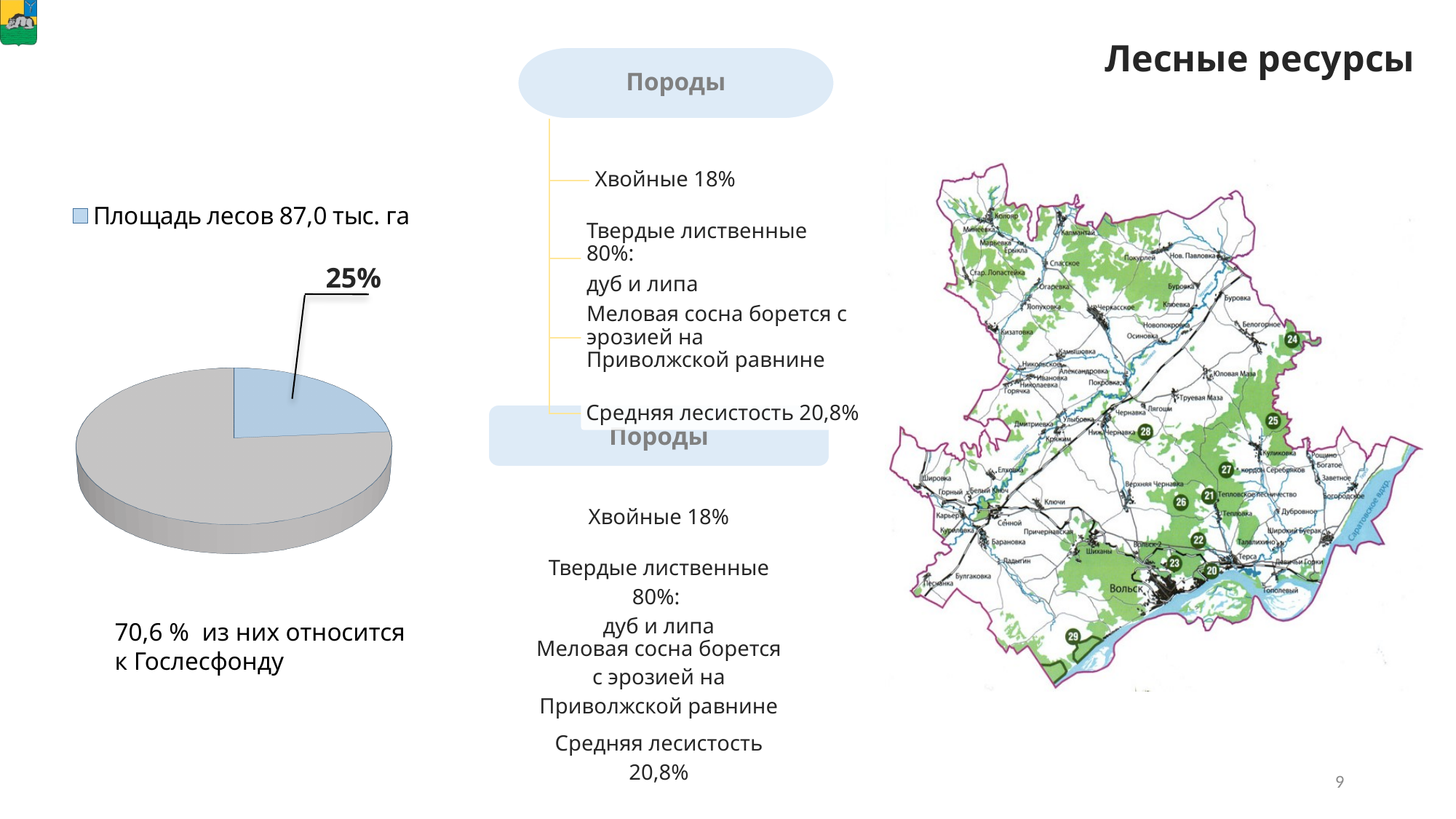
How many slices does the pie chart have? 2 What is the legend entry of the pie chart? Площадь лесов 87,0 тыс. га What share of the pie does the blue slice represent? 25% How many entries does the legend of the pie chart list? 1 What kind of chart is shown on the left of the slide? pie chart Which slice of the pie chart is the smallest? the blue slice (25%) Which slice of the pie chart is larger, the blue slice or the grey slice? the grey slice What colour is the slice labelled 25% in the pie chart? blue What percentage is printed on the labelled slice of the pie chart? 25%